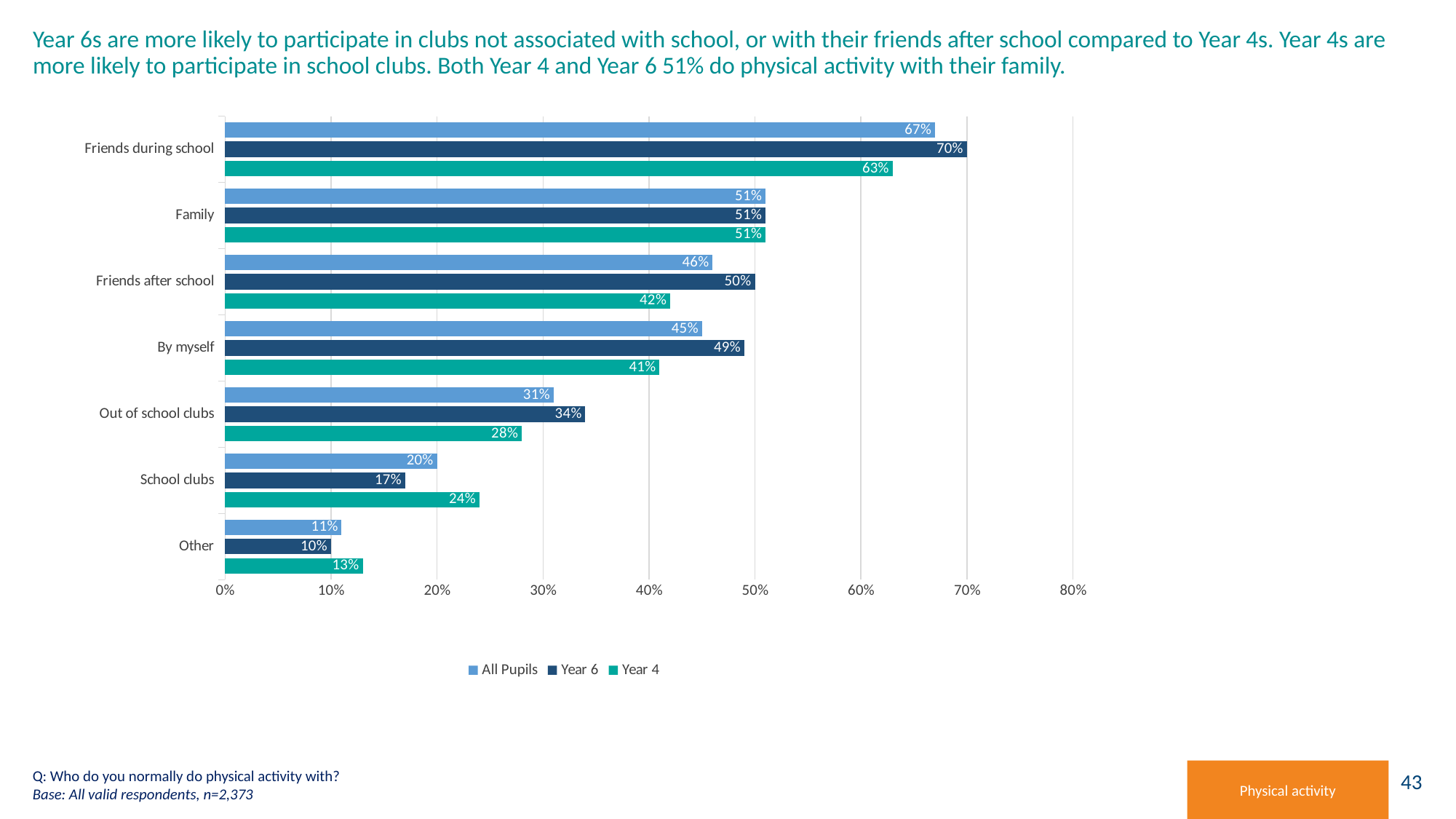
What kind of chart is shown on the slide? Bar chart Is the Year 4 value for By myself greater or less than 40%? greater Which category has the lowest value for Year 6? Other What percentage of Year 6 pupils do physical activity with friends during school? 70% How many series does the legend list? 3 Which category has the highest value for Year 4? Friends during school What is the All Pupils value for Out of school clubs? 31% What is the Year 4 value for School clubs? 24% How many categories are shown on the y axis of the chart? 7 Which series is shown in dark blue in the legend? Year 6 Which is larger for School clubs: the Year 6 value or the Year 4 value? Year 4 What is the difference between the Year 6 and Year 4 values for Friends after school? 8 percentage points